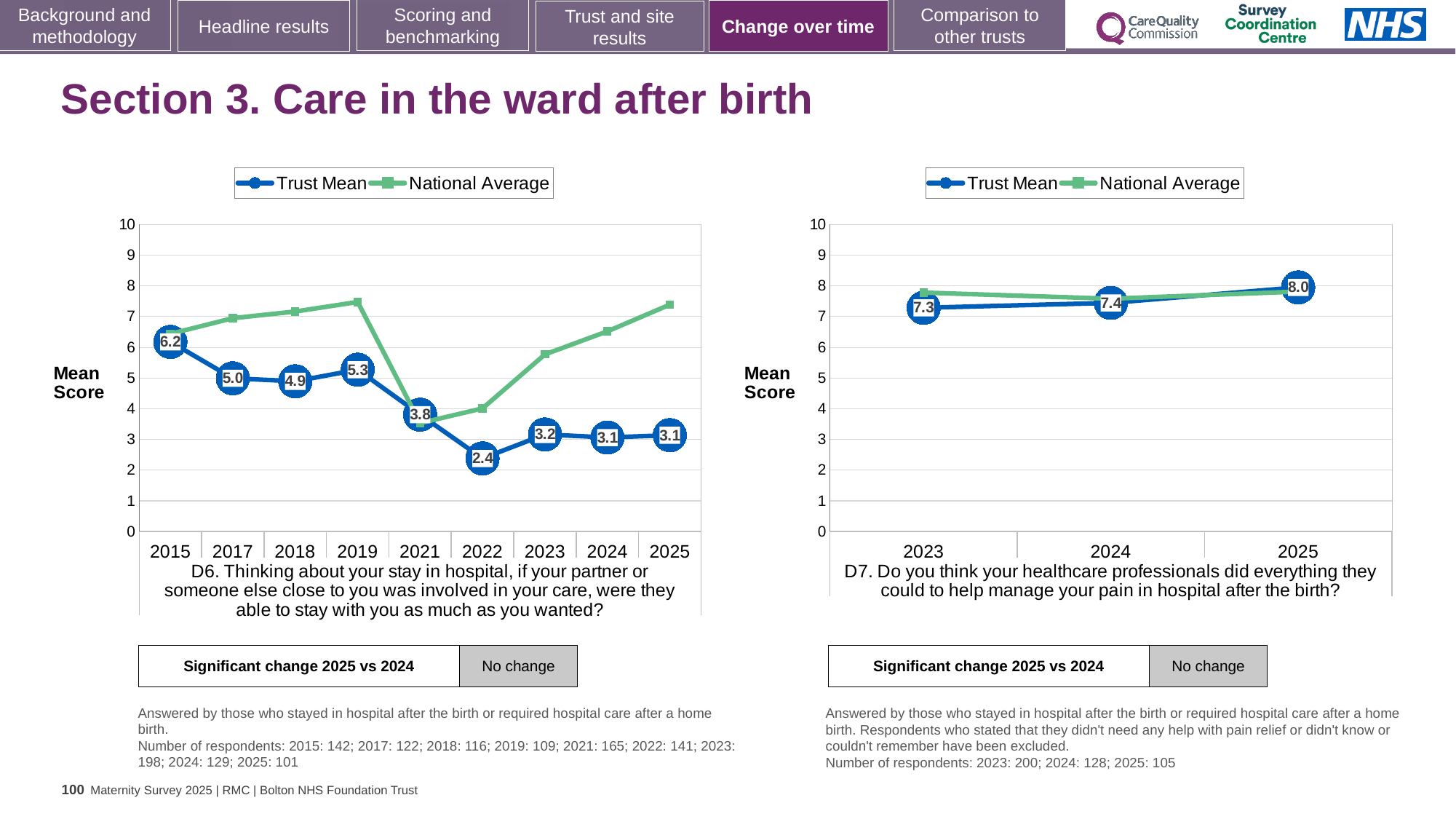
In the D6 chart on the left, what is the Trust Mean score for 2022? 2.4 In the D6 chart on the left, which year has the highest Trust Mean score? 2015 What type of chart is used for the D7 question on the right? Line chart How many series does the legend of the D7 chart on the right list? 2 In the D7 chart on the right, what is the difference between the Trust Mean scores for 2025 and 2023? 0.7 In the D7 chart on the right, does the Trust Mean rise or fall from 2023 to 2025? Rise In the D6 chart on the left, which year has the lowest Trust Mean score? 2022 In the D6 chart on the left, is the Trust Mean score higher in 2019 or in 2021? 2019 In the D6 chart on the left, what is the Trust Mean score for 2015? 6.2 In the D7 chart on the right, what is the Trust Mean score for 2025? 8.0 In the D6 chart on the left, is the National Average for 2025 greater or less than 7? greater How many years are plotted on the x axis of the D6 chart on the left? 9